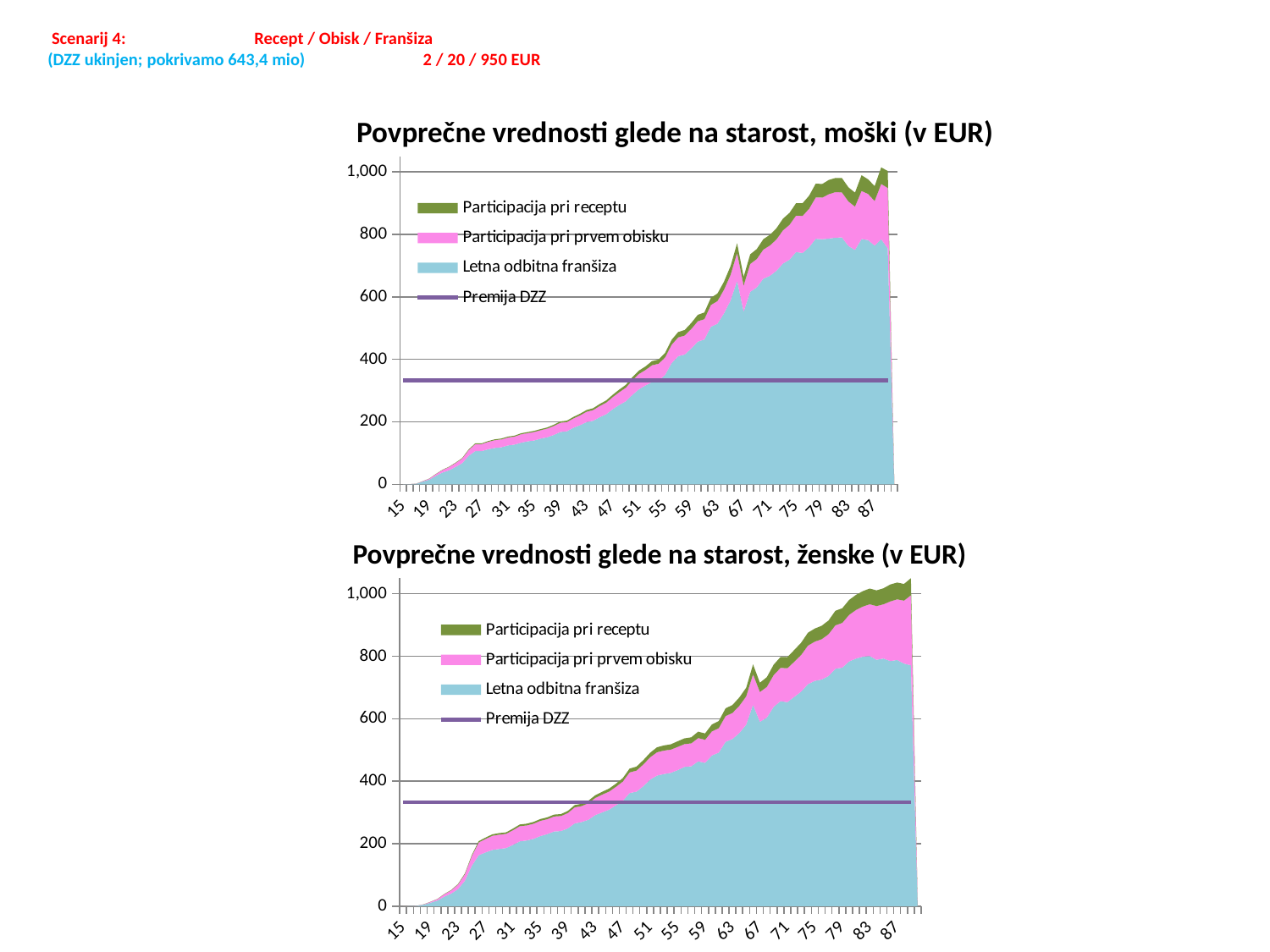
How many series does the legend of the bottom chart (ženske) list? 4 In the top chart (moški), is the Letna odbitna franšiza value at age 87 greater or less than 600? greater In the top chart (moški), is the value of the Premija DZZ line greater or less than 400? less In the top chart (moški), do the stacked values rise or fall as age increases along the x axis? rise What is the title of the bottom chart? Povprečne vrednosti glede na starost, ženske (v EUR) In the bottom chart (ženske), which is larger at age 87: Letna odbitna franšiza or Premija DZZ? Letna odbitna franšiza How many series does the legend of the top chart (moški) list? 4 In the top chart (moški), which is larger at age 23: the Premija DZZ line or the total of the stacked areas? Premija DZZ In the bottom chart (ženske), is the total of the stacked areas at age 87 greater or less than 800? greater What type of chart is the top chart, 'Povprečne vrednosti glede na starost, moški (v EUR)'? area chart In the bottom chart (ženske), which legend entry is drawn as a line rather than a filled area? Premija DZZ